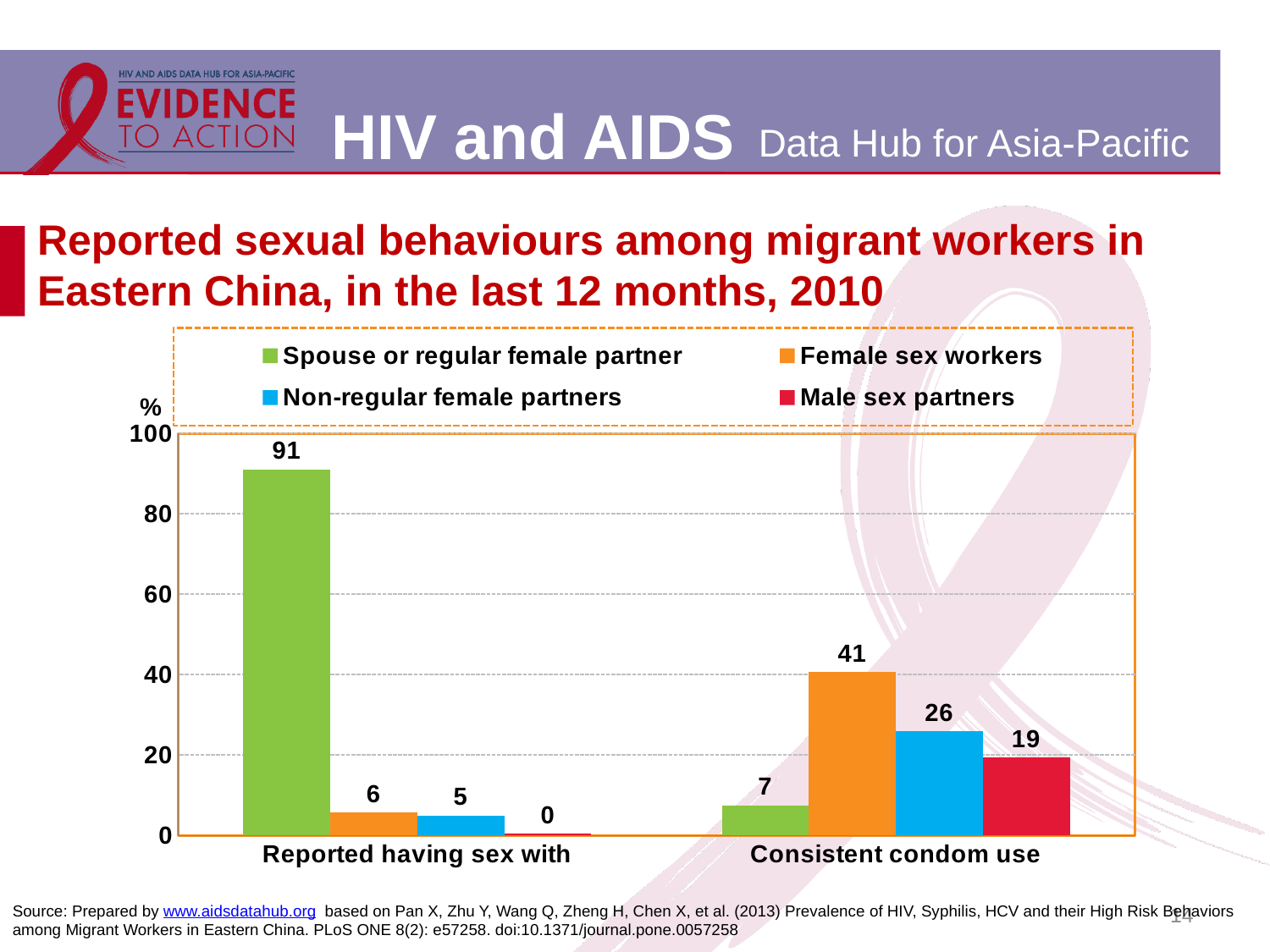
Which partner type has the highest value for consistent condom use? Female sex workers What percentage of migrant workers reported having sex with a spouse or regular female partner? 91 What is the value for consistent condom use with female sex workers? 41 Which partner type has the lowest value for reported having sex with? Male sex partners Which is larger: reported having sex with female sex workers or consistent condom use with female sex workers? Consistent condom use with female sex workers What is the difference between consistent condom use with female sex workers and with non-regular female partners? 15 What percentage reported having sex with non-regular female partners? 5 What is the value for consistent condom use with male sex partners? 19 How many series does the legend list? 4 What kind of chart is shown on the slide? Bar chart Is the value for reported having sex with a spouse or regular female partner greater or less than 80? greater What colour represents female sex workers in the chart? Orange